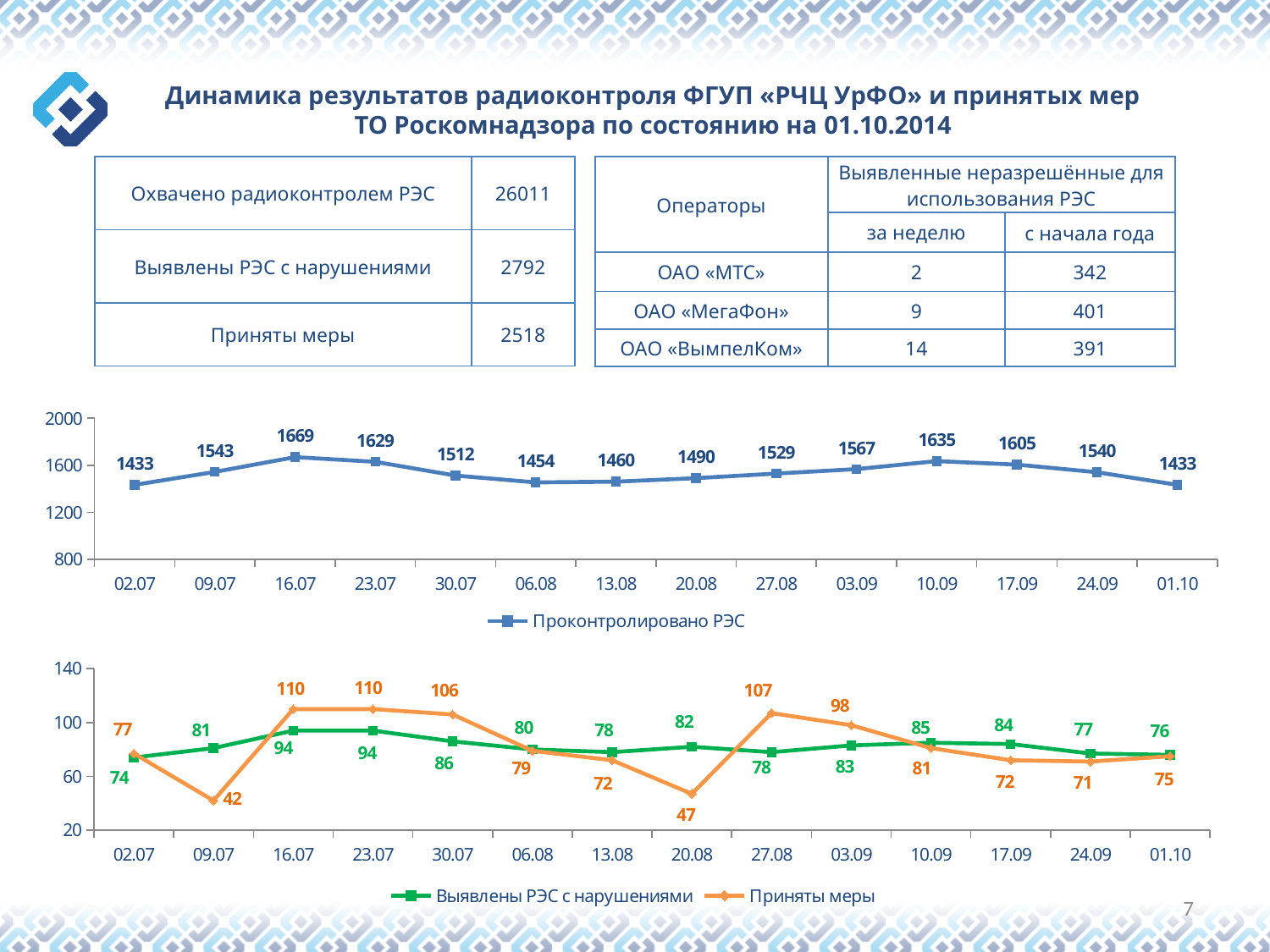
In the bottom chart, what is the value of Выявлены РЭС с нарушениями for 30.07? 86 In the bottom chart, what is the difference between Приняты меры and Выявлены РЭС с нарушениями on 16.07? 16 In the top chart (Проконтролировано РЭС), what is the difference between the values for 10.09 and 24.09? 95 In the bottom chart, what is the value of Приняты меры for 20.08? 47 In the bottom chart, which date has the lowest value for Приняты меры? 09.07 In the bottom chart, which is larger on 27.08: Выявлены РЭС с нарушениями or Приняты меры? Приняты меры In the top chart (Проконтролировано РЭС), which date has the highest value? 16.07 In the top chart (Проконтролировано РЭС), what is the value for 16.07? 1669 In the top chart (Проконтролировано РЭС), how many data points are plotted? 14 How many series does the legend of the bottom chart list? 2 What type of chart is the top chart on the slide? Line chart In the top chart (Проконтролировано РЭС), is the value for 06.08 greater or less than 1600? less